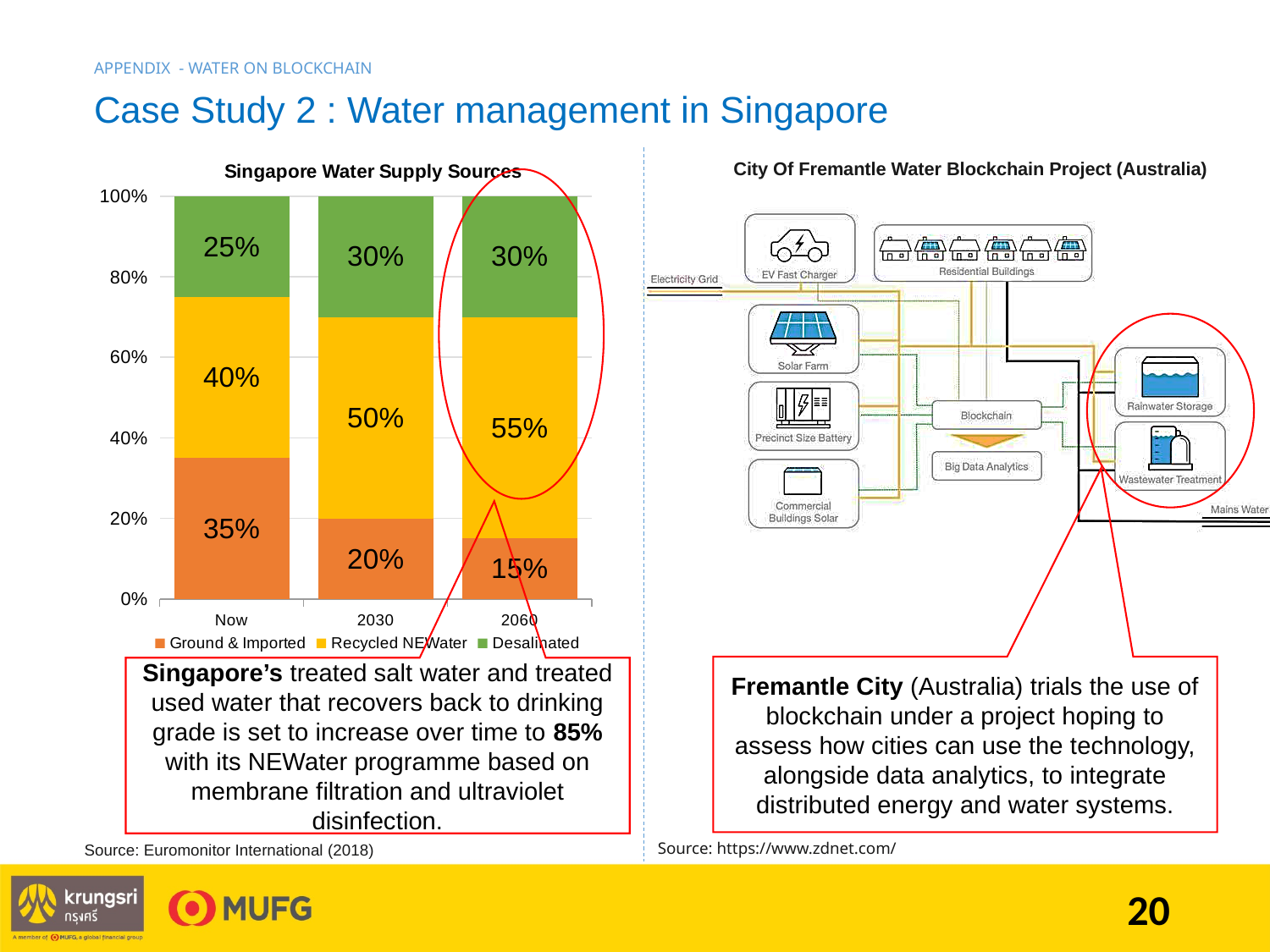
Does the Ground & Imported share rise or fall from Now to 2060? Fall In which year is the Ground & Imported share lowest? 2060 How many years (categories) are shown on the x axis? 3 In which year is the Recycled NEWater share highest? 2060 What is the difference between the Recycled NEWater share in 2060 and in Now? 15% Which is larger: Ground & Imported in 2030 or Desalinated in 2030? Desalinated in 2030 What kind of chart is shown? Stacked bar chart What is the value for Desalinated in 2030? 30% What is the value for Ground & Imported in the Now bar? 35% What is the title of the chart? Singapore Water Supply Sources How many series does the legend list? 3 What is the value for Recycled NEWater in 2060? 55%